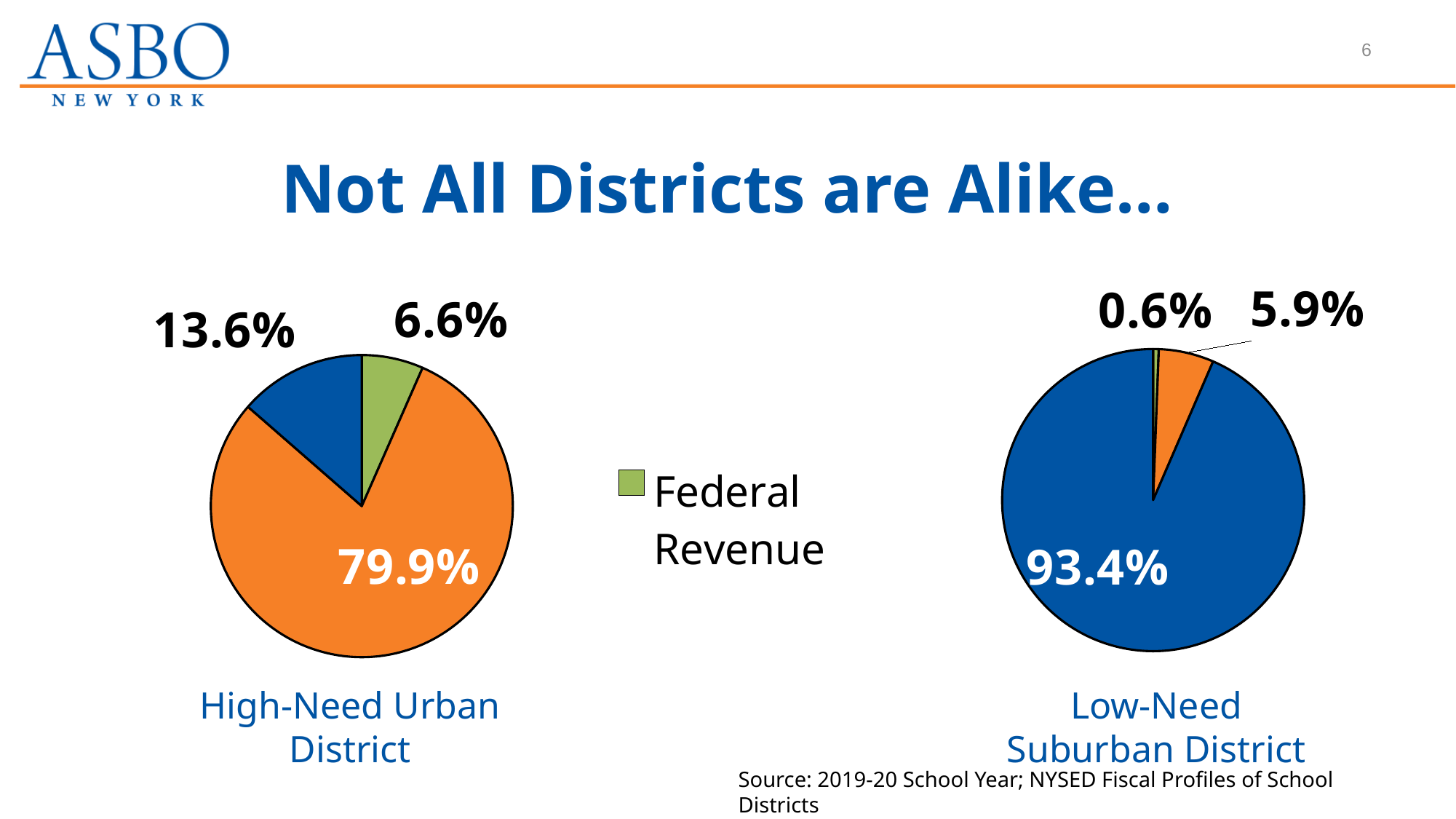
In the Low-Need Suburban District pie chart, what share is Federal Revenue? 0.6% What is the difference between the orange slice in the High-Need Urban District pie chart and the orange slice in the Low-Need Suburban District pie chart? 74.0% In the High-Need Urban District pie chart, what share is Federal Revenue? 6.6% How many slices does the High-Need Urban District pie chart have? 3 In the Low-Need Suburban District pie chart, what is the value of the orange slice? 5.9% What kind of charts are shown on the slide? Pie charts In the Low-Need Suburban District pie chart, what is the value of the largest slice? 93.4% Which district has the larger Federal Revenue share, the High-Need Urban District or the Low-Need Suburban District? High-Need Urban District What is the difference between the Federal Revenue share in the High-Need Urban District and in the Low-Need Suburban District? 6.0% In the High-Need Urban District pie chart, what is the value of the smallest slice? 6.6% How many entries does the legend list? 1 In the High-Need Urban District pie chart, what is the value of the largest slice? 79.9%